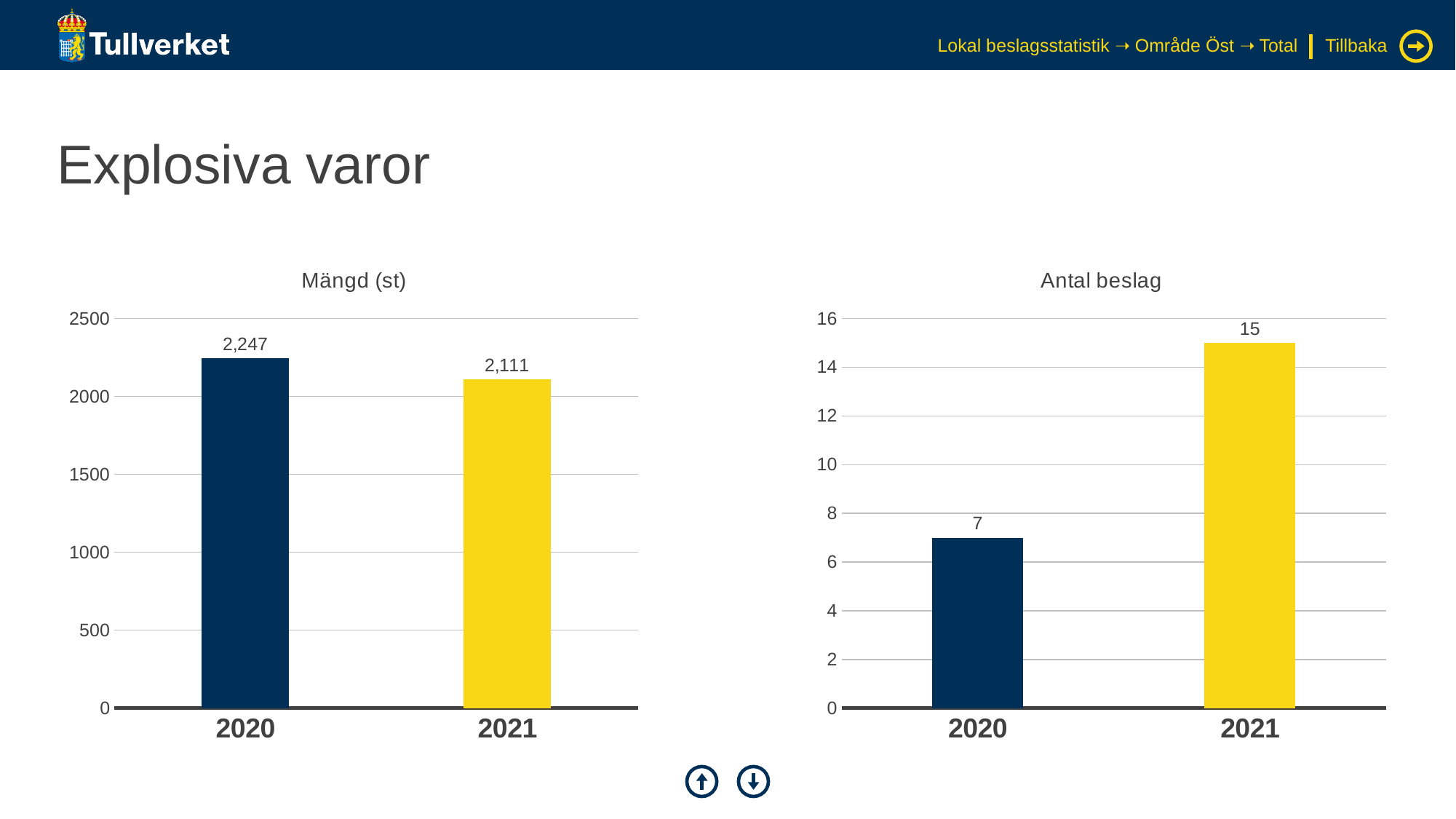
What kind of chart is the 'Antal beslag' chart? bar chart In the 'Mängd (st)' chart, is the value for 2021 greater or less than 2000? greater In the 'Antal beslag' chart, is the value for 2021 greater or less than 2020? greater In the 'Antal beslag' chart, do the values rise or fall from 2020 to 2021? rise In the 'Antal beslag' chart, what is the value for 2021? 15 In the 'Mängd (st)' chart, what is the value for 2020? 2,247 In the 'Antal beslag' chart, what is the difference between the 2021 and 2020 values? 8 In the 'Mängd (st)' chart, what is the difference between the 2020 and 2021 values? 136 In the 'Mängd (st)' chart, which year has the higher value? 2020 In the 'Antal beslag' chart, what is the value for 2020? 7 In the 'Mängd (st)' chart, what is the value for 2021? 2,111 In the 'Antal beslag' chart, which year has the lower value? 2020